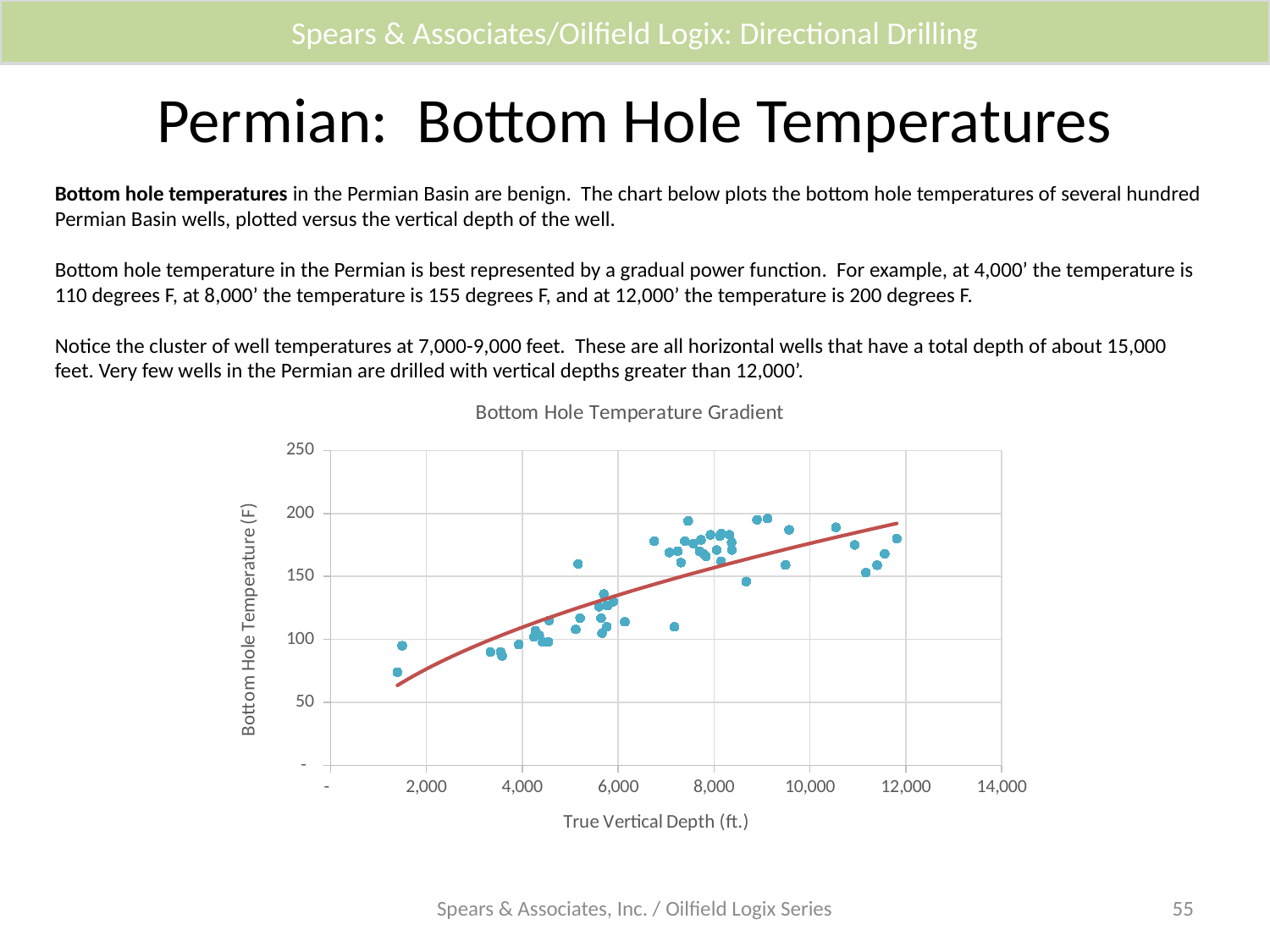
Is the value of the red trend line at 6,000 ft greater or less than 150? less Is the lowest plotted point on the chart greater or less than 100 degrees F? less Is the highest plotted point on the chart greater or less than 200 degrees F? less What is the label of the vertical axis of the chart? Bottom Hole Temperature (F) What kind of chart is shown on the slide? Scatter chart What is the title of the chart? Bottom Hole Temperature Gradient What is the highest tick value shown on the vertical axis? 250 Do the plotted bottom hole temperatures generally rise or fall as true vertical depth increases? Rise